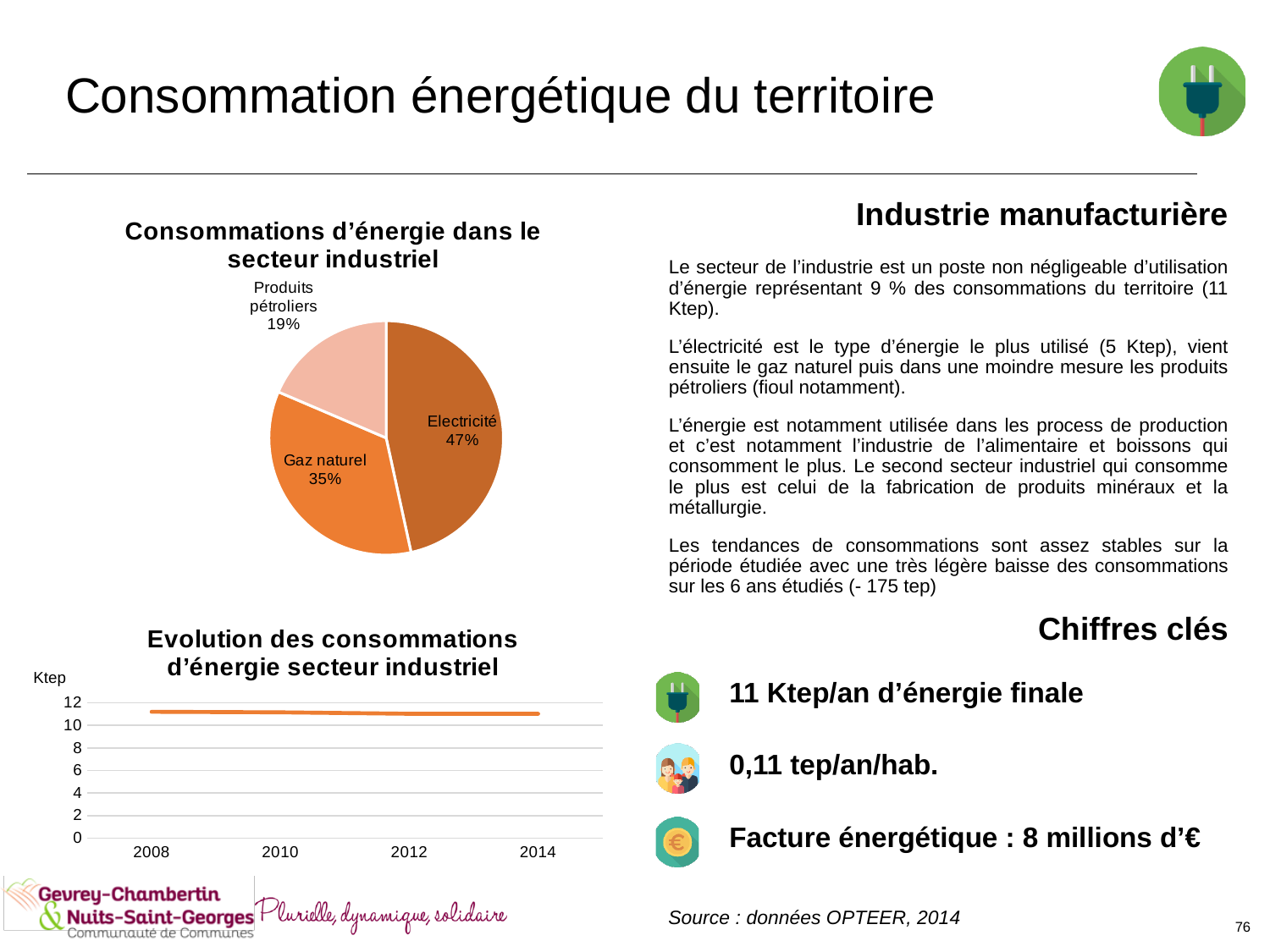
In the pie chart 'Consommations d'énergie dans le secteur industriel', how many percentage points larger is the Electricité share than the Gaz naturel share? 12 In the pie chart 'Consommations d'énergie dans le secteur industriel', which energy type has the largest share? Electricité What kind of chart is 'Evolution des consommations d'énergie secteur industriel'? Line chart In the chart 'Evolution des consommations d'énergie secteur industriel', is the value for 2008 greater or less than 10? greater In the pie chart 'Consommations d'énergie dans le secteur industriel', what share does Electricité have? 47% What unit is shown on the vertical axis of the chart 'Evolution des consommations d'énergie secteur industriel'? Ktep In the pie chart 'Consommations d'énergie dans le secteur industriel', which is larger: Gaz naturel or Produits pétroliers? Gaz naturel How many slices does the pie chart 'Consommations d'énergie dans le secteur industriel' have? 3 In the pie chart 'Consommations d'énergie dans le secteur industriel', what share do Produits pétroliers have? 19% In the pie chart 'Consommations d'énergie dans le secteur industriel', which energy type has the smallest share? Produits pétroliers What kind of chart is 'Consommations d'énergie dans le secteur industriel'? Pie chart In the pie chart 'Consommations d'énergie dans le secteur industriel', what share does Gaz naturel have? 35%